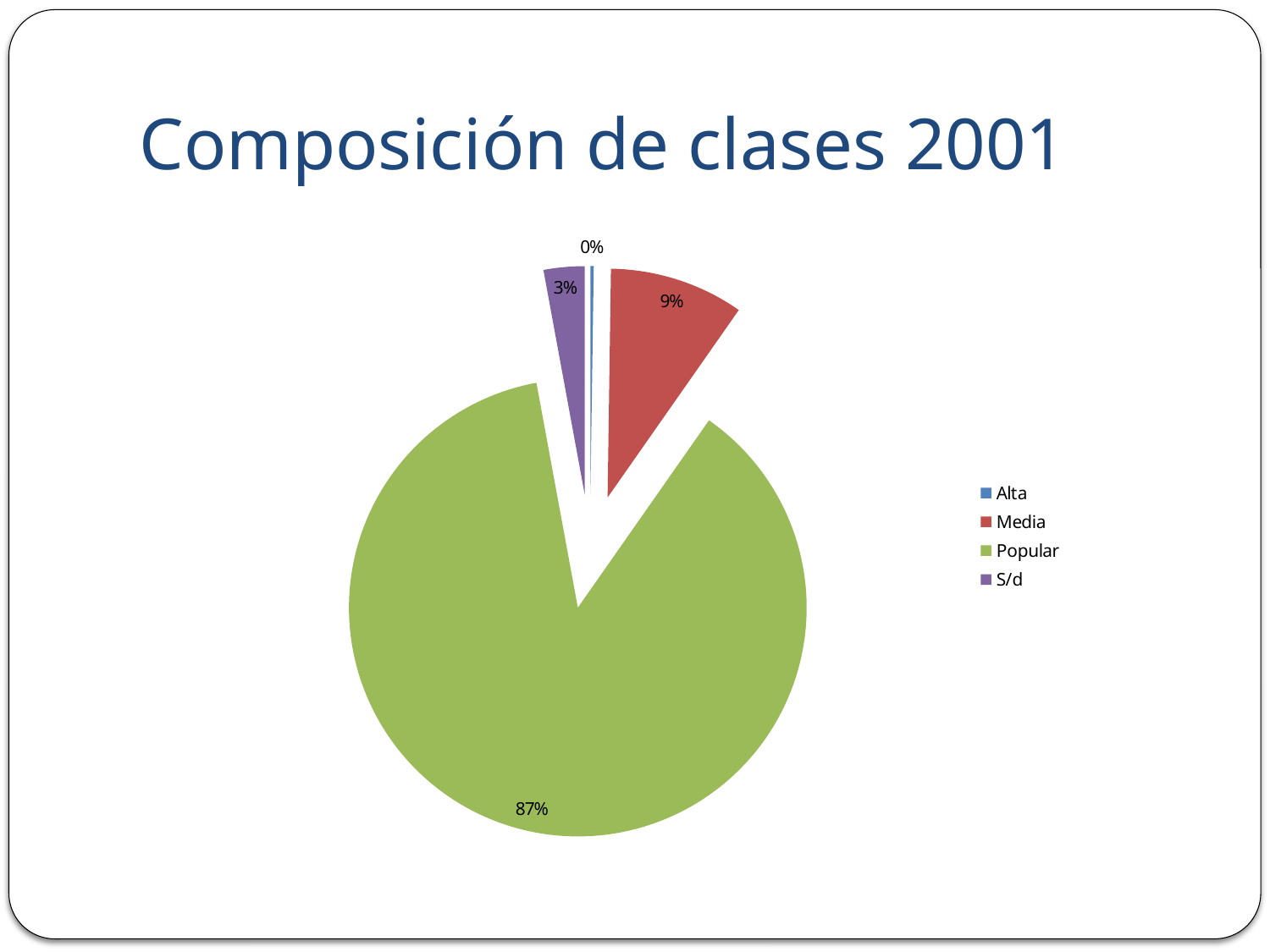
How many categories does the pie chart show? 4 What share of the pie does Alta hold? 0% What is the title of the slide? Composición de clases 2001 What is the difference in percentage points between Media and S/d? 6 What share of the pie does Popular hold? 87% What is the difference in percentage points between Popular and Media? 78 Which is larger, the share for Media or the share for S/d? Media What kind of chart is shown on the slide? Pie chart Which category has the smallest slice of the pie? Alta Which category has the largest slice of the pie? Popular What share of the pie does S/d hold? 3%